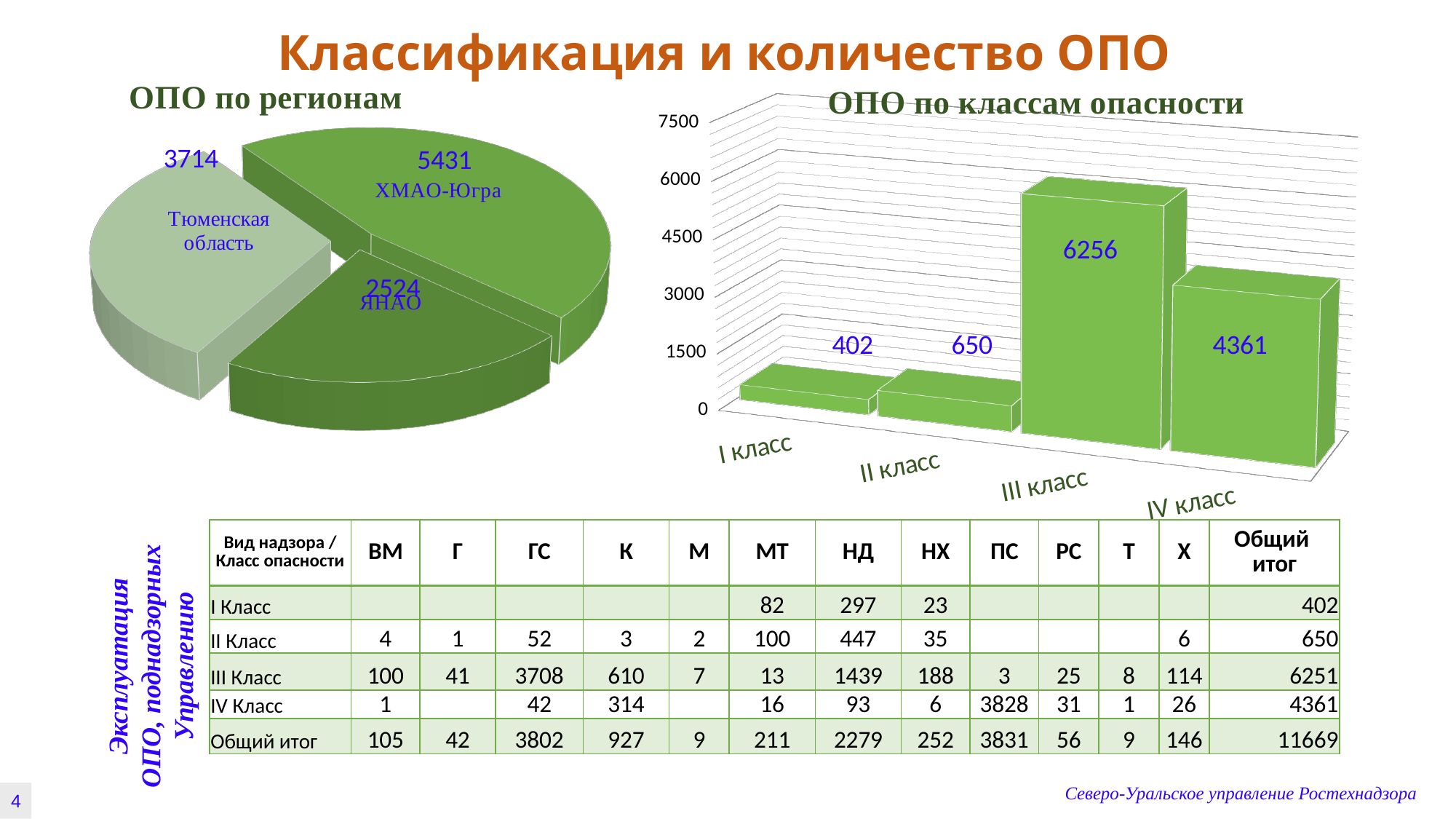
In the chart 'ОПО по регионам', what is the value for ХМАО-Югра? 5431 In the chart 'ОПО по классам опасности', what is the value for I класс? 402 In the chart 'ОПО по классам опасности', what is the value for III класс? 6256 In the chart 'ОПО по регионам', what is the value for Тюменская область? 3714 In the chart 'ОПО по регионам', which region has the smallest slice? ЯНАО How many slices does the pie chart 'ОПО по регионам' have? 3 What kind of chart is 'ОПО по классам опасности'? Bar chart What kind of chart is 'ОПО по регионам'? Pie chart In the chart 'ОПО по классам опасности', is the value for IV класс greater or less than 3000? greater In the chart 'ОПО по регионам', what is the difference between the values for ХМАО-Югра and Тюменская область? 1717 In the chart 'ОПО по классам опасности', what is the difference between III класс and IV класс? 1895 In the chart 'ОПО по классам опасности', which class has the highest value? III класс